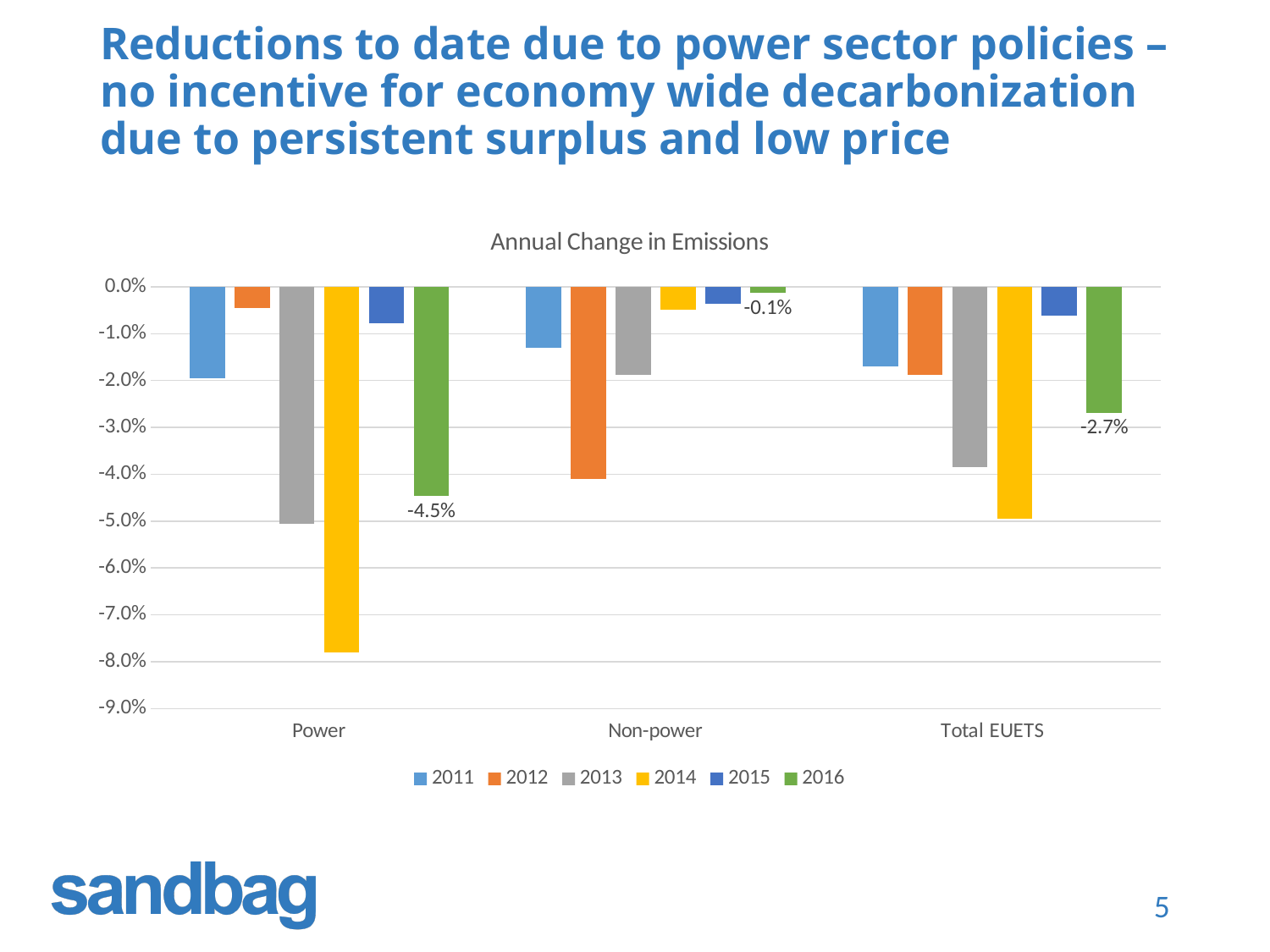
Is the value for 2014 in the Power category greater or less than -7.0%? less What is the value for 2016 in the Total EUETS category? -2.7% How many categories are shown on the x axis? 3 Which is larger, the 2016 value for Power or the 2016 value for Total EUETS? Total EUETS What is the value for 2016 in the Power category? -4.5% Which year has the lowest value in the Power category? 2014 Which year has the highest value (closest to zero) in the Non-power category? 2016 What is the difference between the 2016 value for Power and the 2016 value for Total EUETS? 1.8 percentage points What is the value for 2016 in the Non-power category? -0.1% Is the value for 2013 in the Total EUETS category greater or less than -4.0%? greater Which year has the lowest value in the Non-power category? 2012 How many series does the legend list? 6